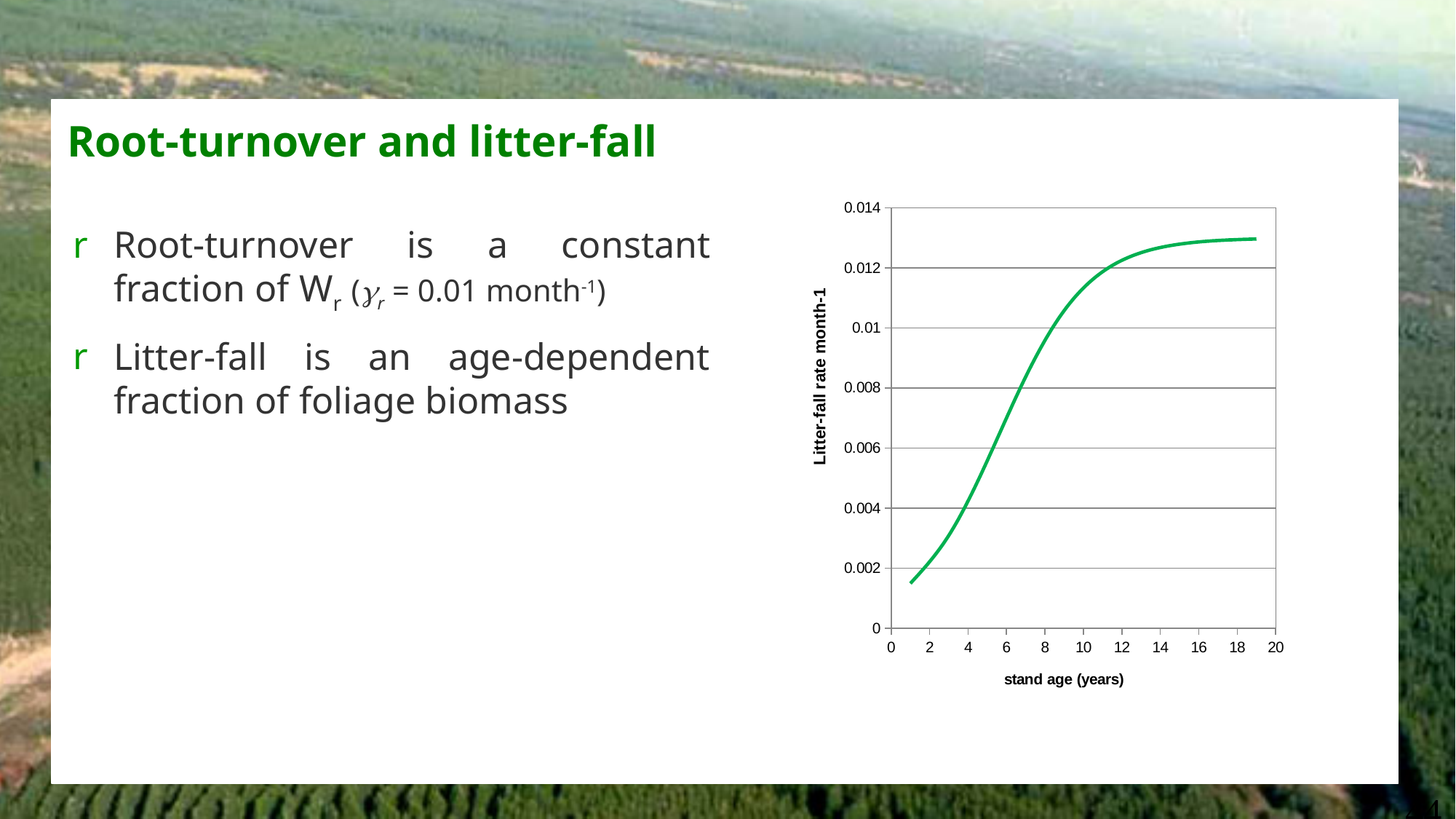
Is the litter-fall rate higher at a stand age of 14 years or at a stand age of 4 years? 14 years Is the litter-fall rate at a stand age of 10 years greater or less than 0.01? greater What kind of chart is shown on the slide? line chart Is the litter-fall rate at a stand age of 6 years greater or less than 0.006? greater Is the litter-fall rate at a stand age of 2 years greater or less than 0.004? less Does the litter-fall rate rise or fall as stand age increases? rises What is the label of the vertical axis of the chart? Litter-fall rate month-1 What is the label of the horizontal axis of the chart? stand age (years)